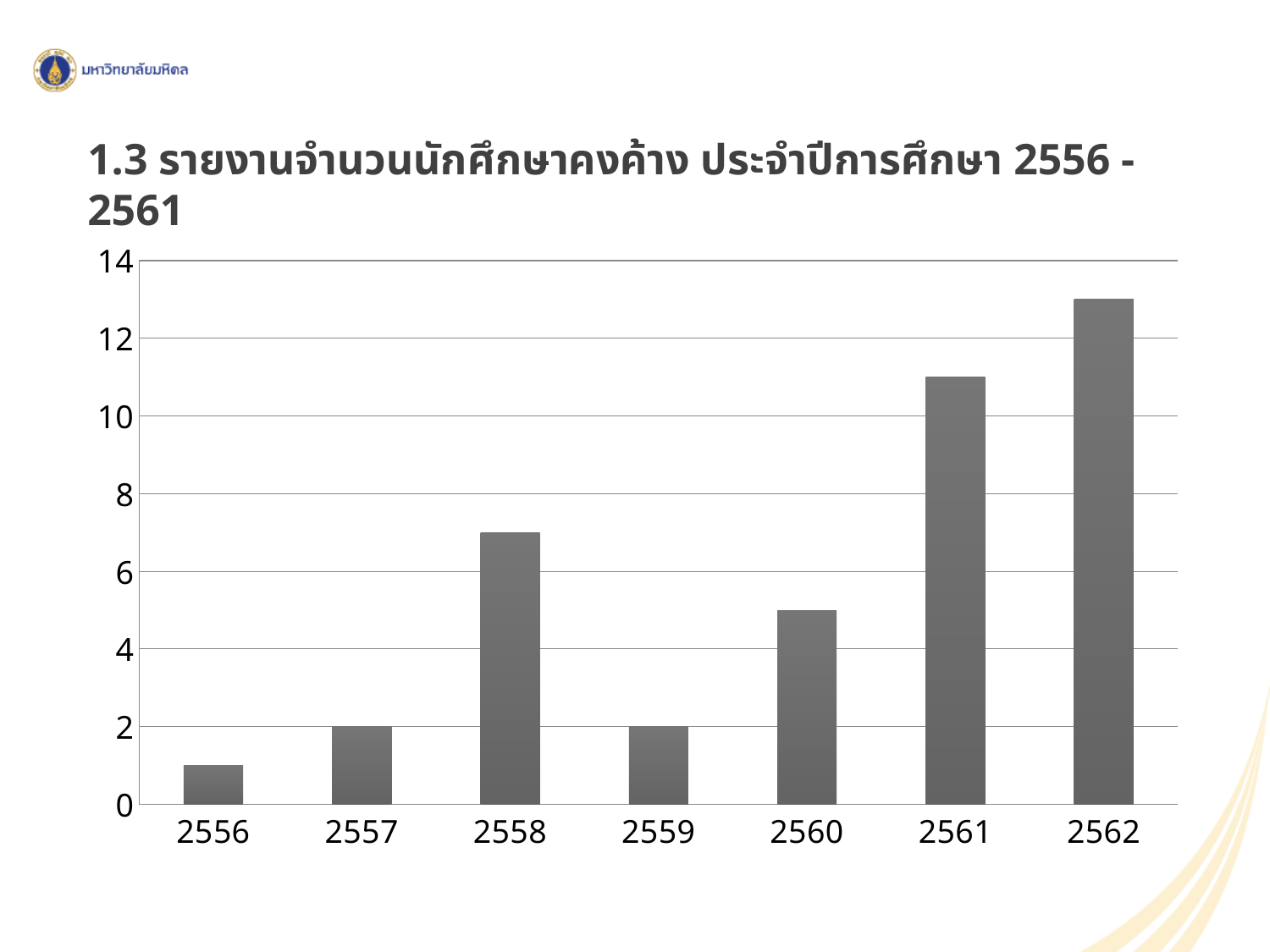
Which year has the larger value, 2558 or 2560? 2558 Is the value for 2561 greater or less than 10? greater Is the value for 2556 greater or less than 2? less How many years (categories) are shown on the x axis of the chart? 7 Is the value for 2562 greater or less than 12? greater Do the values rise or fall from 2559 to 2562? rise What is the value for 2557 in the chart? 2 What is the value for 2559 in the chart? 2 Which year has the lowest bar in the chart? 2556 Which year has the highest bar in the chart? 2562 What kind of chart is shown on the slide? bar chart